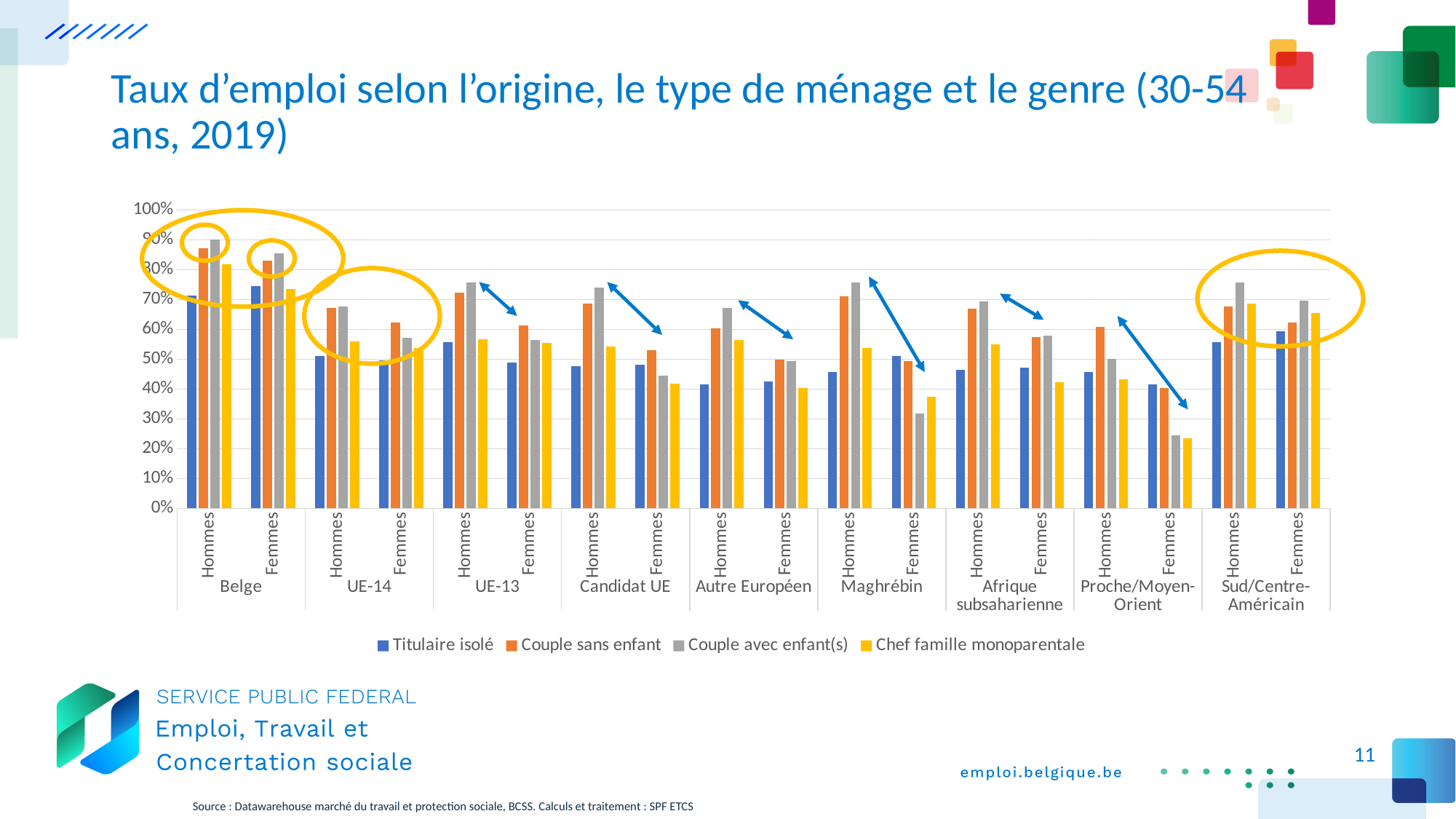
Which origin group has the lowest value for Chef famille monoparentale? Proche/Moyen-Orient Femmes Is the value for Couple sans enfant among Maghrébin Hommes greater or less than 60%? greater Is the value for Couple avec enfant(s) among Belge Hommes greater or less than 80%? greater Is the value for Couple avec enfant(s) among Proche/Moyen-Orient Femmes greater or less than 30%? less Which colour represents Chef famille monoparentale in the legend? yellow Which is larger for Candidat UE Hommes: Titulaire isolé or Couple sans enfant? Couple sans enfant How many series does the legend list? 4 What kind of chart is shown on the slide? bar chart Which origin group has the highest value for Couple avec enfant(s)? Belge Hommes How many origin groups are shown along the x axis? 9 Which is larger for Maghrébin: Couple avec enfant(s) for Hommes or Couple avec enfant(s) for Femmes? Hommes